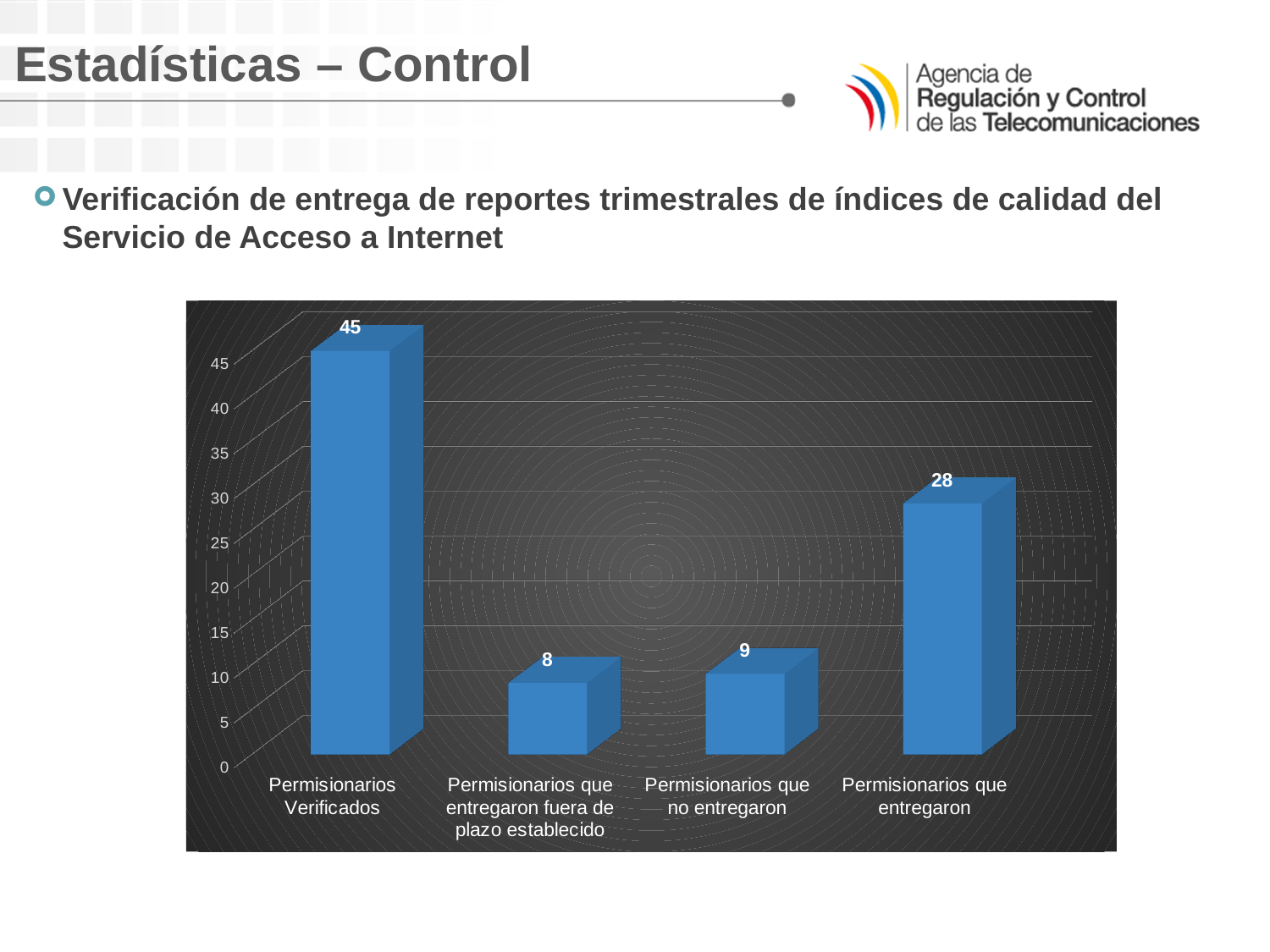
What is the value for Permisionarios Verificados? 45 What kind of chart is shown on the slide? bar chart What is the value for Permisionarios que entregaron fuera de plazo establecido? 8 What is the difference between Permisionarios que no entregaron and Permisionarios que entregaron fuera de plazo establecido? 1 Which category has the highest value? Permisionarios Verificados What is the value for Permisionarios que no entregaron? 9 What is the value for Permisionarios que entregaron? 28 Which category has the lowest value? Permisionarios que entregaron fuera de plazo establecido What is the difference between Permisionarios Verificados and Permisionarios que entregaron? 17 Which is larger: Permisionarios que entregaron or Permisionarios que no entregaron? Permisionarios que entregaron How many categories are shown in the chart? 4 Is the value for Permisionarios que entregaron greater or less than 25? greater